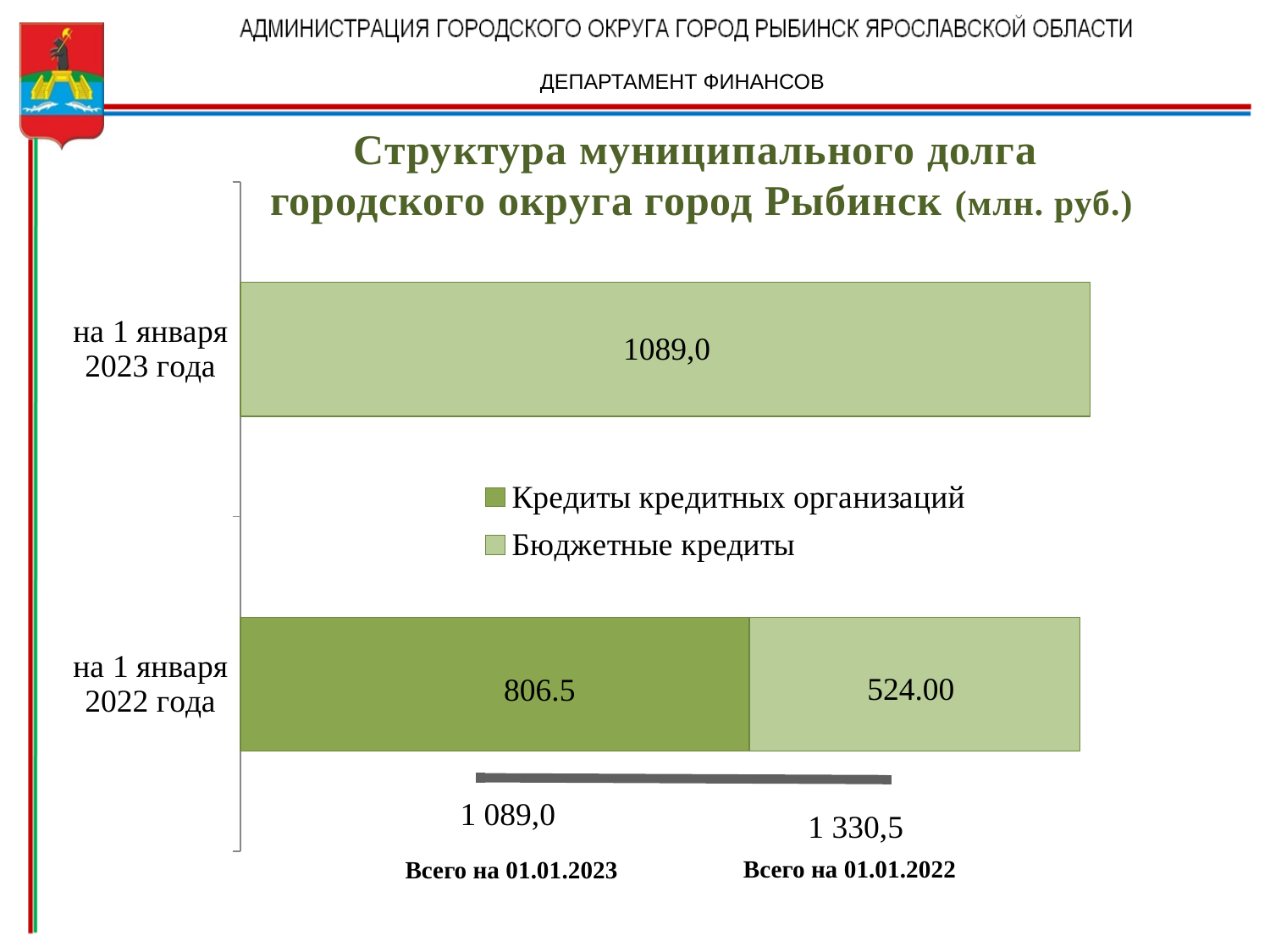
What is the total municipal debt shown for 01.01.2022? 1 330,5 How many series does the legend list? 2 Which series is shown in the darker green colour in the legend? Кредиты кредитных организаций What unit is given in the chart title? млн. руб. What is the difference between Кредиты кредитных организаций and Бюджетные кредиты for на 1 января 2022 года? 282.5 What is the value of Кредиты кредитных организаций for на 1 января 2022 года? 806.5 How many categories (dates) are shown on the chart? 2 What type of chart is shown on the slide? bar chart What is the value of Бюджетные кредиты for на 1 января 2023 года? 1089,0 What is the value of Бюджетные кредиты for на 1 января 2022 года? 524.00 What is the total municipal debt shown for 01.01.2023? 1 089,0 Which is larger for на 1 января 2022 года: Кредиты кредитных организаций or Бюджетные кредиты? Кредиты кредитных организаций